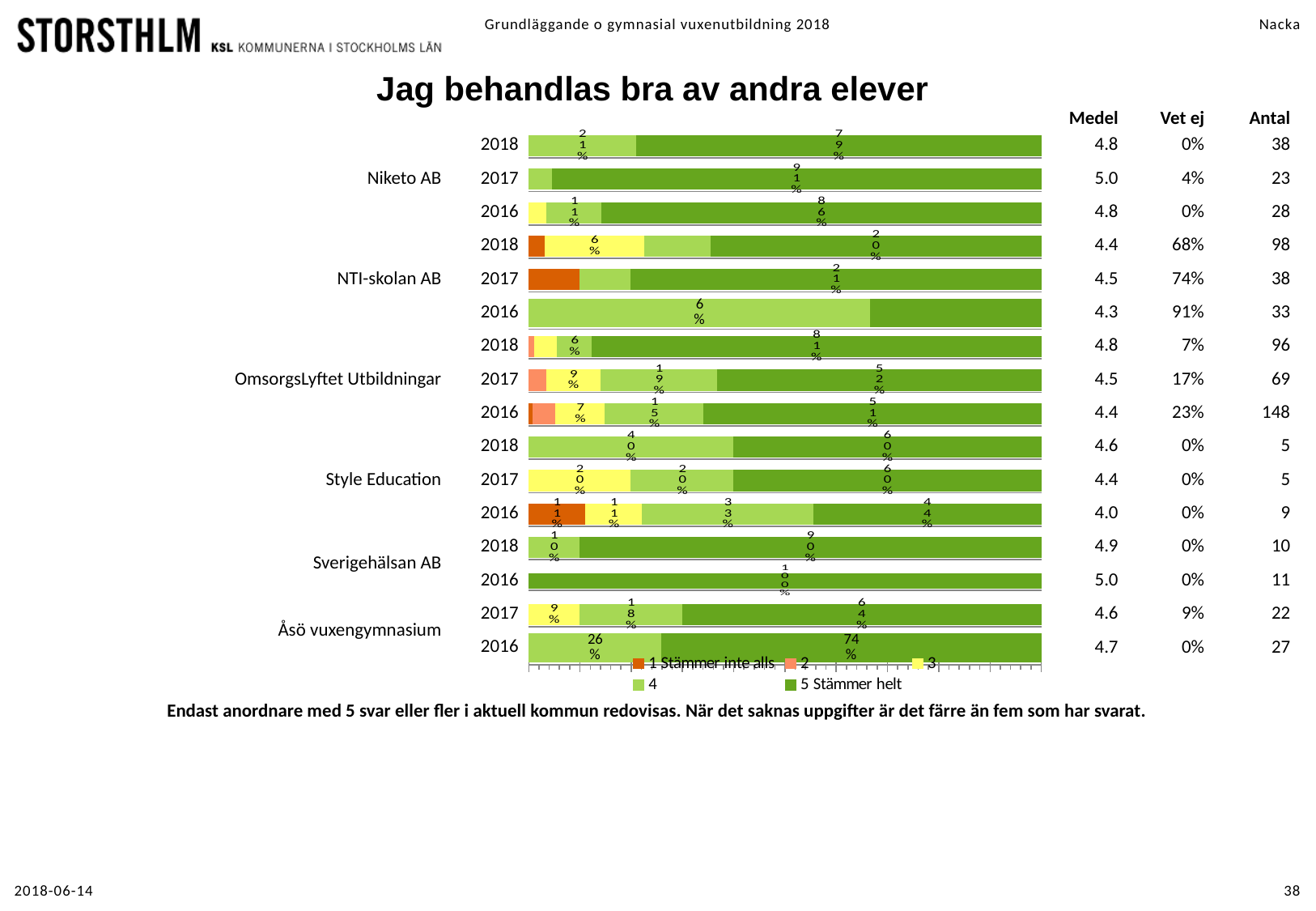
What is the title of the chart? Jag behandlas bra av andra elever Which is larger: the '5 Stämmer helt' segment for Åsö vuxengymnasium in 2016 or for Style Education in 2018? Åsö vuxengymnasium 2016 Which provider-year row has the highest 'Antal' value in the table next to the chart? OmsorgsLyftet Utbildningar 2016 How many bars (provider-year rows) are plotted in the chart? 16 What is the value of the '5 Stämmer helt' segment for Sverigehälsan AB in 2016? 100% What is the value of the '4' segment for Åsö vuxengymnasium in 2016? 26% How many series does the legend list? 5 What is the value of the '4' segment for Style Education in 2016? 33% What kind of chart is shown on the slide? bar chart What is the difference between the '5 Stämmer helt' and '4' segments for Åsö vuxengymnasium in 2016? 48 percentage points What is the value of the '5 Stämmer helt' segment for Style Education in 2018? 60% What is the value of the '5 Stämmer helt' segment for Åsö vuxengymnasium in 2016? 74%